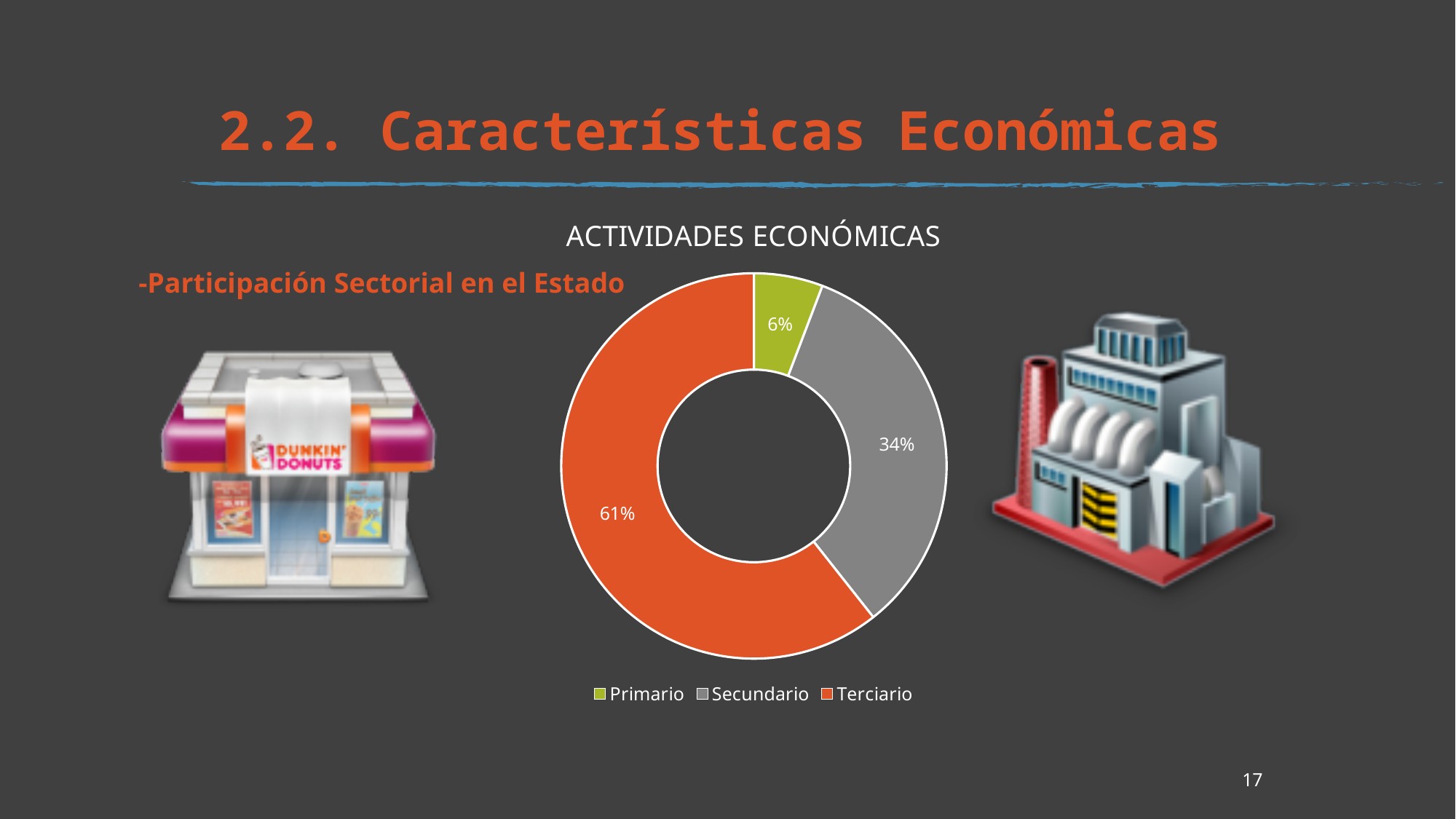
What is the difference between the Terciario and Secundario shares in the ACTIVIDADES ECONÓMICAS chart? 27% What colour represents Terciario in the ACTIVIDADES ECONÓMICAS chart? Orange Which sector has the smallest share in the ACTIVIDADES ECONÓMICAS chart? Primario How many sectors are shown in the ACTIVIDADES ECONÓMICAS chart? 3 What is the difference between the Secundario and Primario shares in the ACTIVIDADES ECONÓMICAS chart? 28% What kind of chart is the ACTIVIDADES ECONÓMICAS chart? Doughnut chart What is the value for Terciario in the ACTIVIDADES ECONÓMICAS chart? 61% What is the value for Secundario in the ACTIVIDADES ECONÓMICAS chart? 34% What is the title of the chart on the slide? ACTIVIDADES ECONÓMICAS Which is larger in the ACTIVIDADES ECONÓMICAS chart, Secundario or Primario? Secundario What is the value for Primario in the ACTIVIDADES ECONÓMICAS chart? 6% Which sector has the largest share in the ACTIVIDADES ECONÓMICAS chart? Terciario